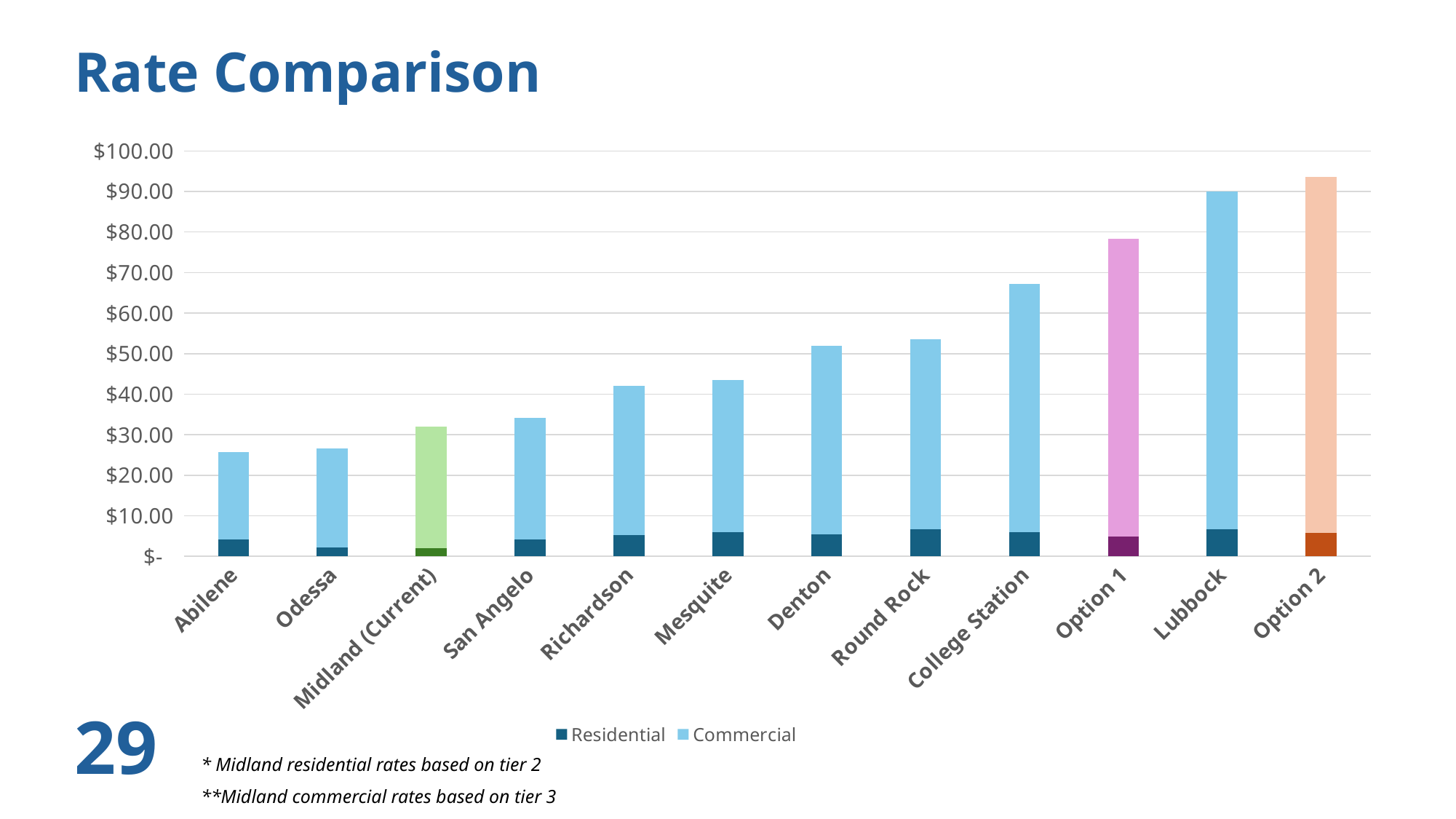
What kind of chart is shown on the slide? Stacked bar chart What are the two series named in the legend? Residential and Commercial Is the total value for Option 1 greater or less than $70.00? greater Is the total value for San Angelo greater or less than $40.00? less Which category has the highest total bar? Option 2 Which has the larger total bar, Lubbock or College Station? Lubbock Is the total value for College Station greater or less than $60.00? greater Do the total bar values generally rise or fall from left to right along the x axis? Rise How many categories are shown along the x axis of the chart? 12 How many series does the legend list? 2